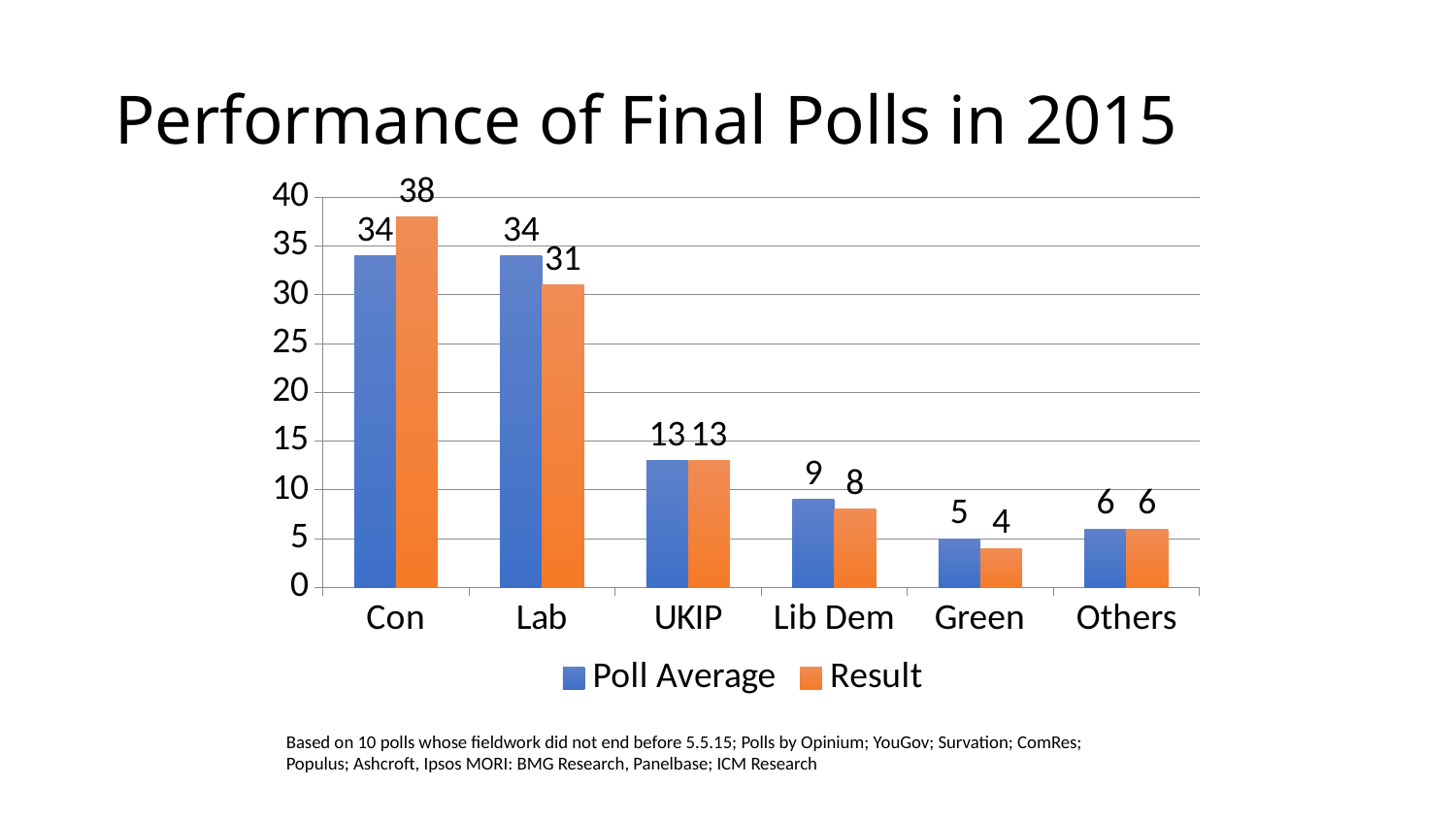
What is the Result value for Green? 4 How many series does the legend list? 2 Which category has the highest Result value? Con What is the title of the chart? Performance of Final Polls in 2015 What is the Poll Average value for Con? 34 What is the difference between the Result and the Poll Average for Con? 4 Which is larger for Lib Dem, the Poll Average or the Result? Poll Average What is the Result value for Lab? 31 Which category has the lowest Poll Average value? Green What kind of chart is shown on the slide? Bar chart How many categories are shown on the x axis? 6 What is the difference between the Poll Average and the Result for Lab? 3